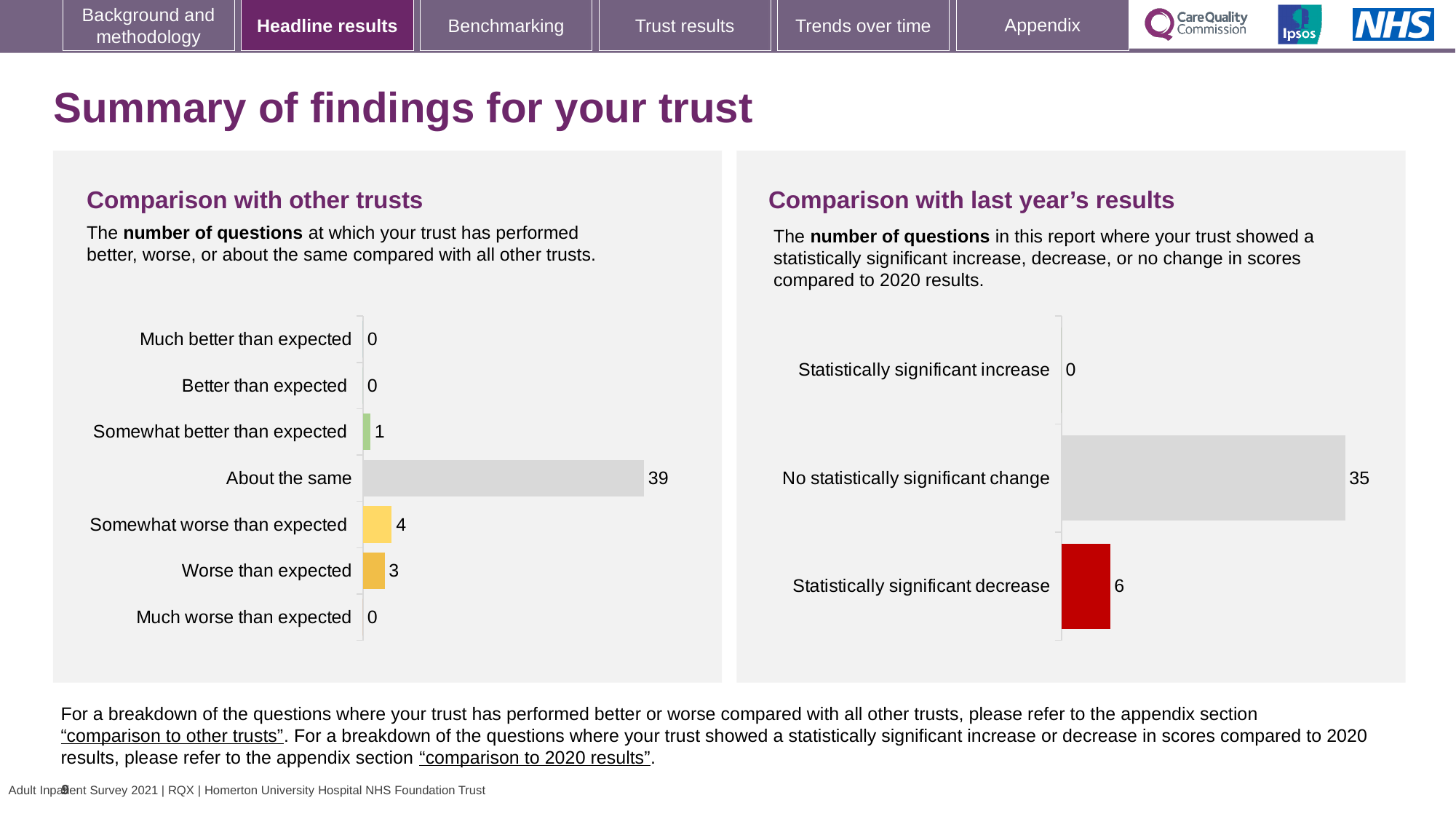
In the 'Comparison with last year's results' chart, how many questions showed no statistically significant change? 35 In the 'Comparison with other trusts' chart, what is the difference between 'Somewhat worse than expected' and 'Worse than expected'? 1 In the 'Comparison with other trusts' chart, which category has the highest value? About the same In the 'Comparison with other trusts' chart, how many categories are shown? 7 What type of chart is the 'Comparison with last year's results' chart? Bar chart In the 'Comparison with other trusts' chart, which is larger: 'Somewhat better than expected' or 'Worse than expected'? Worse than expected In the 'Comparison with last year's results' chart, what colour is the 'Statistically significant decrease' bar? Red In the 'Comparison with last year's results' chart, what is the difference between 'No statistically significant change' and 'Statistically significant decrease'? 29 In the 'Comparison with last year's results' chart, how many questions showed a statistically significant decrease? 6 In the 'Comparison with other trusts' chart, how many questions are 'About the same'? 39 In the 'Comparison with last year's results' chart, how many categories are shown? 3 In the 'Comparison with other trusts' chart, how many questions are 'Somewhat worse than expected'? 4